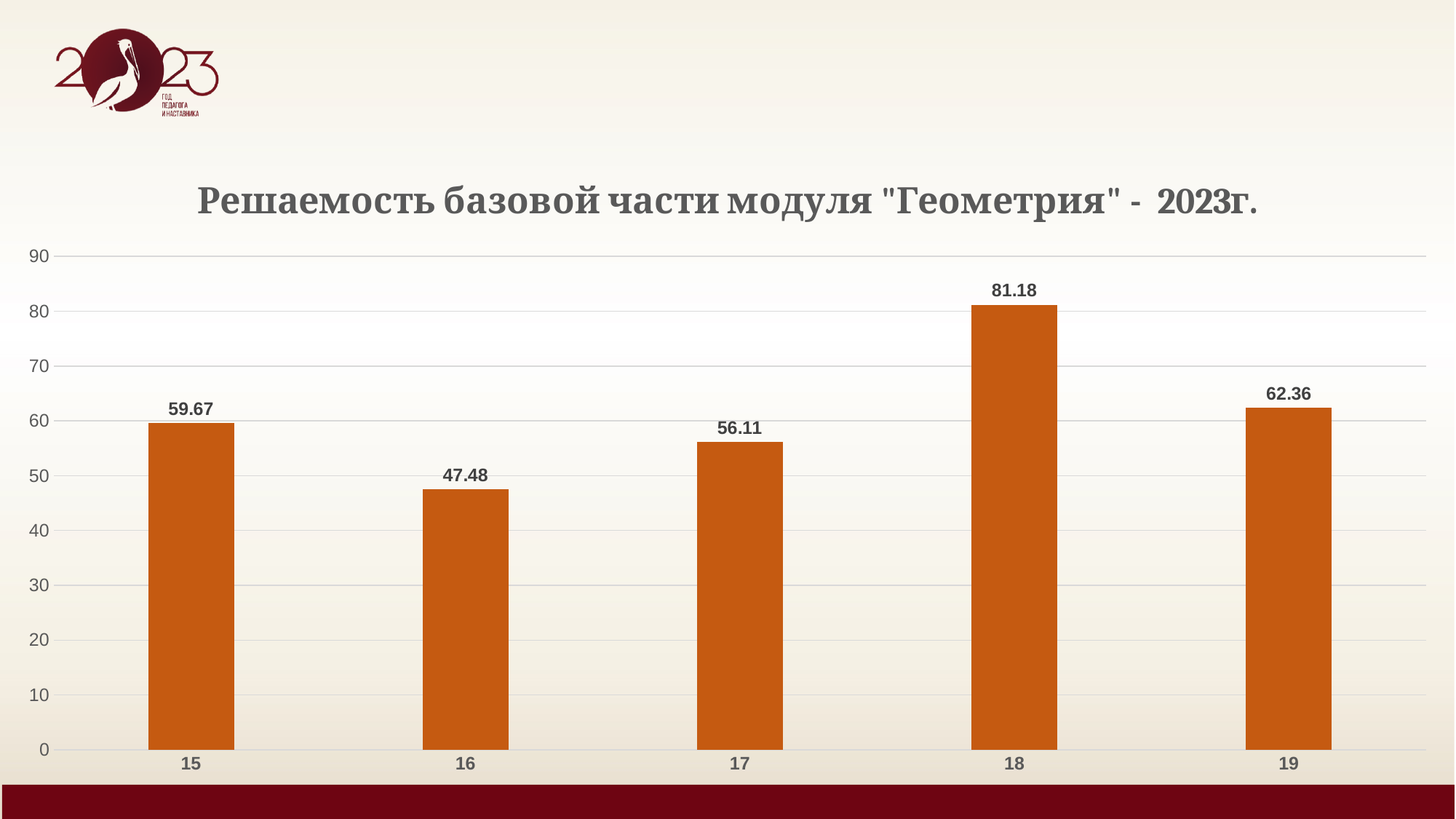
What is the value for category 18? 81.18 Which is larger, the value for 15 or the value for 17? 15 What kind of chart is shown on the slide? bar chart What is the difference between the values for 18 and 16? 33.70 What is the value for category 16? 47.48 Which category has the lowest value? 16 How many categories are shown on the x axis? 5 What is the difference between the values for 19 and 17? 6.25 Which category has the highest value? 18 What is the value for category 15? 59.67 What is the title of the chart? Решаемость базовой части модуля "Геометрия" - 2023г. Is the value for 19 greater or less than 60? greater